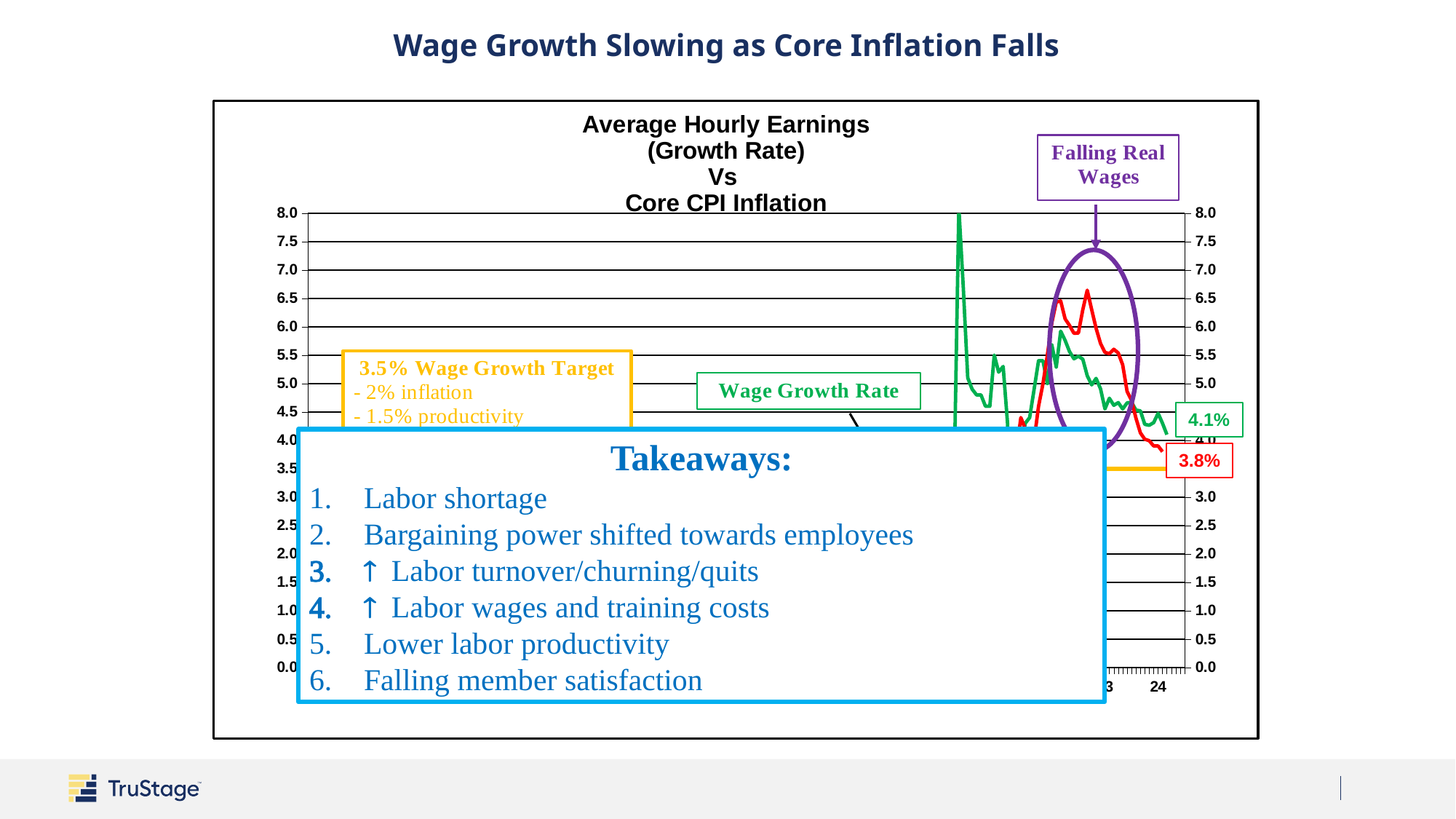
At the end of the chart, which is larger: the Wage Growth Rate or Core CPI Inflation? Wage Growth Rate What is the difference between the latest labeled Wage Growth Rate (4.1%) and the latest labeled Core CPI Inflation (3.8%)? 0.3% Is the peak of the green Wage Growth Rate line greater or less than 7.0? greater What is the latest labeled value of the Core CPI Inflation (red line)? 3.8% What is the maximum value shown on the chart's vertical axis? 8.0 Is the latest labeled Wage Growth Rate of 4.1% greater or less than the 3.5% wage growth target shown on the chart? greater What is the latest labeled value of the Wage Growth Rate (green line)? 4.1% What does the purple annotation box on the chart say? Falling Real Wages What kind of chart is shown on the slide? line chart How many data series (lines) are plotted on the chart? 3 Is the peak of the red Core CPI Inflation line greater or less than 6.0? greater